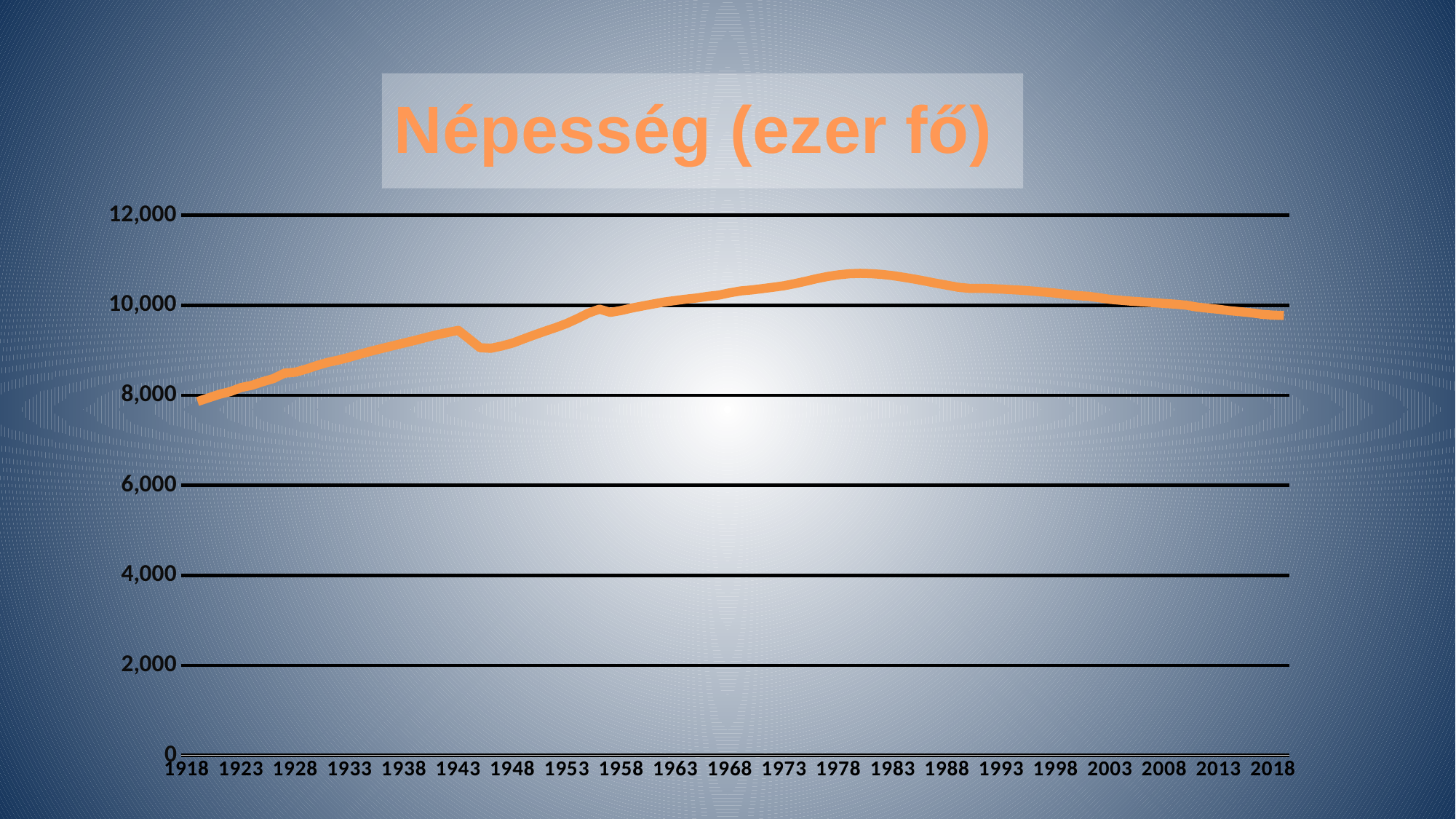
Is the value for 1948 greater or less than 10,000? less Is the value for 1988 greater or less than 10,000? greater Is the value for 1943 greater or less than 8,000? greater Do the values rise or fall from 1983 to 2018? fall Do the values rise or fall from 1918 to 1978? rise What is the title of the chart? Népesség (ezer fő) What kind of chart is shown on the slide? line chart Which is larger, the value for 1978 or the value for 2018? 1978 Which is larger, the value for 1943 or the value for 1948? 1943